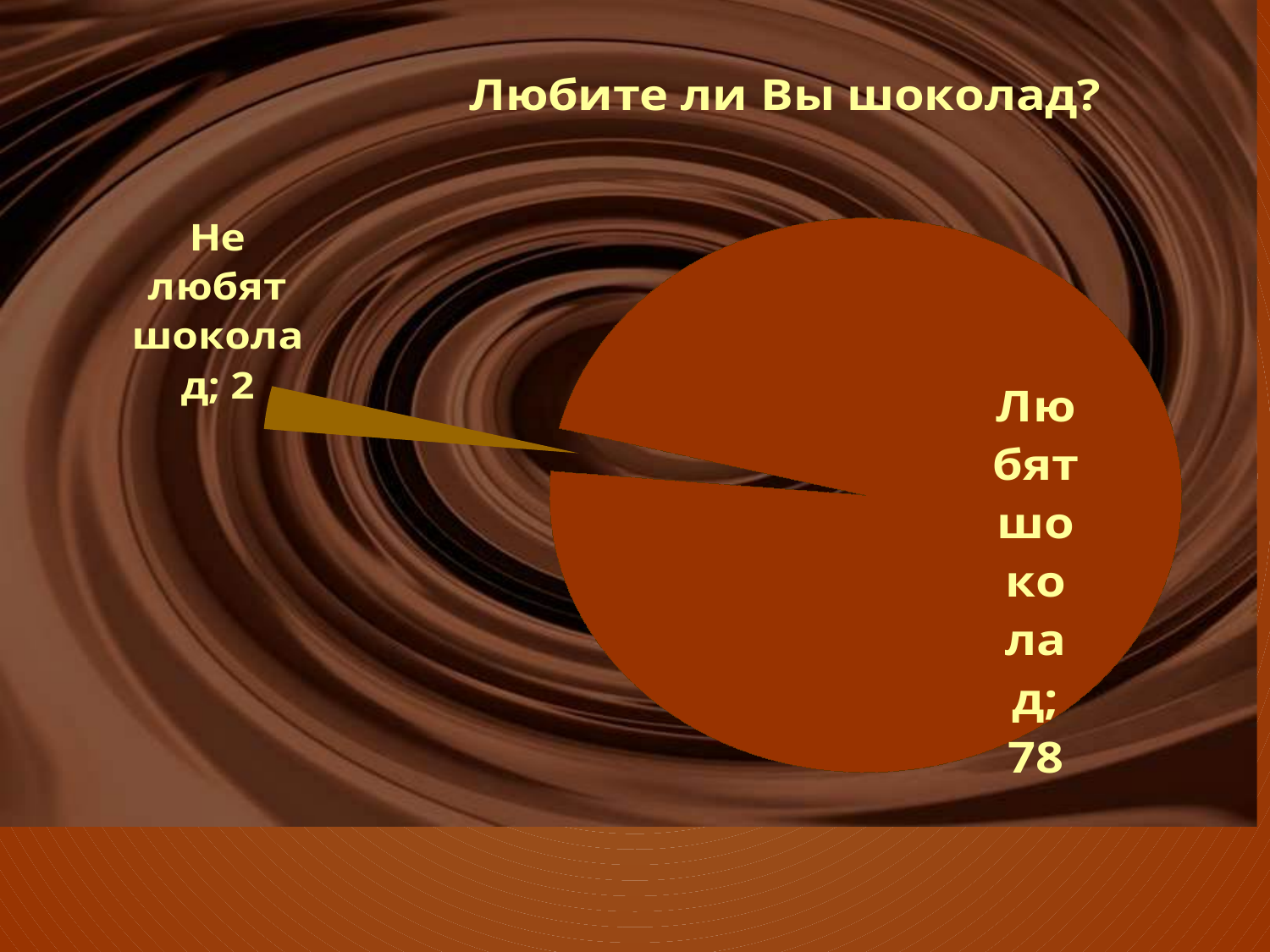
Which slice is the largest? Любят шоколад What kind of chart is shown on the slide? pie chart What is the difference between the values for "Любят шоколад" and "Не любят шоколад"? 76 What is the total of all slices in the pie chart? 80 What is the value for "Не любят шоколад"? 2 What is the title of the chart? Любите ли Вы шоколад? Which slice is the smallest? Не любят шоколад How many slices does the pie chart have? 2 What is the value for "Любят шоколад"? 78 What share of the pie does "Не любят шоколад" represent? 2.5% What share of the pie does "Любят шоколад" represent? 97.5% Which is larger, "Любят шоколад" or "Не любят шоколад"? Любят шоколад